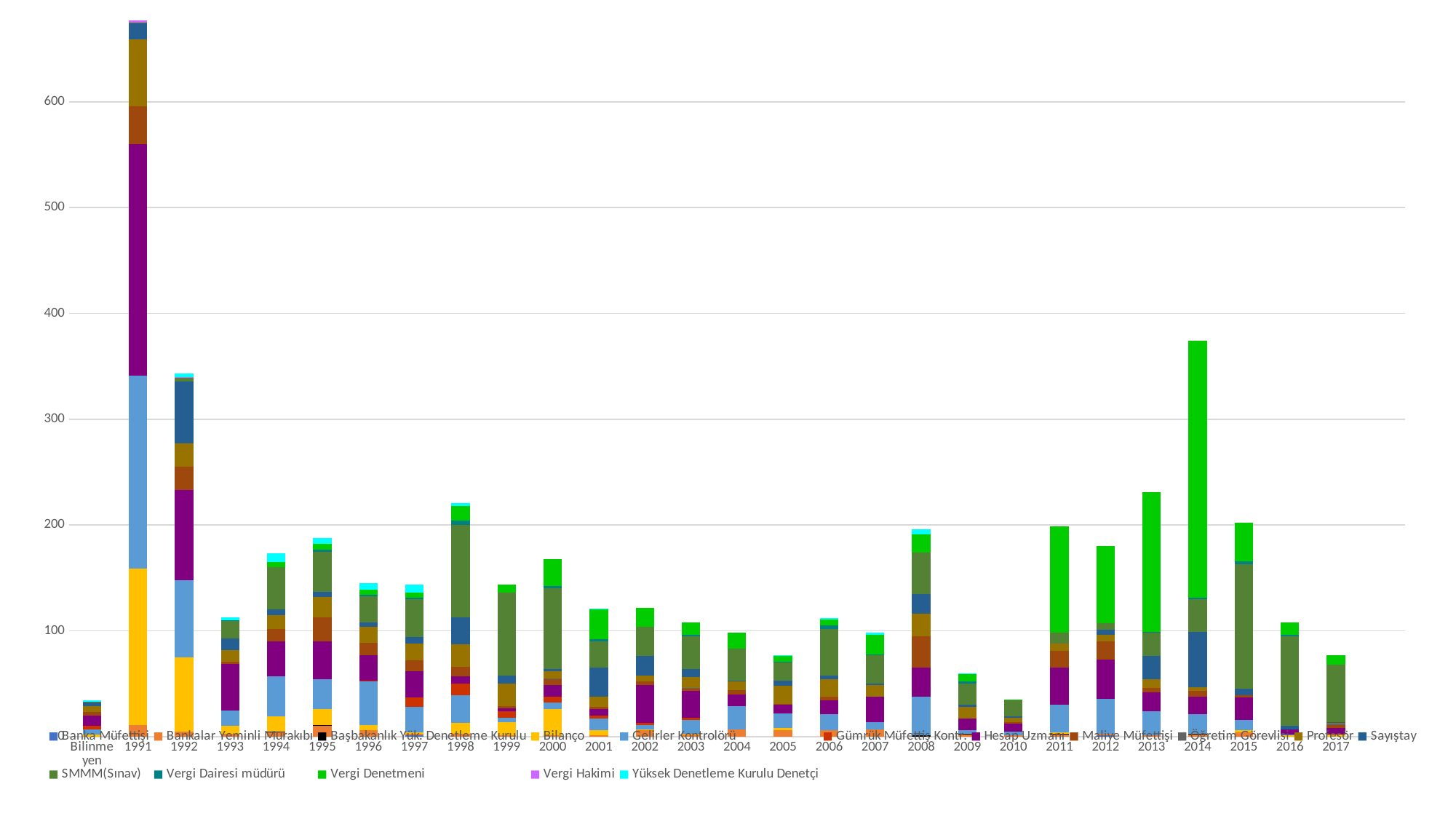
How many series does the legend list? 16 Which year has the tallest stacked bar? 1991 How many categories are shown along the x axis? 28 Which bar is taller, 2014 or 2013? 2014 Is the total for 1991 greater or less than 600? greater What kind of chart is shown on the slide? Stacked bar chart Is the total for 2017 greater or less than 100? less Is the total for 2013 greater or less than 200? greater Which legend entry is shown in bright green? Vergi Denetmeni Which bar is taller, 1991 or 1992? 1991